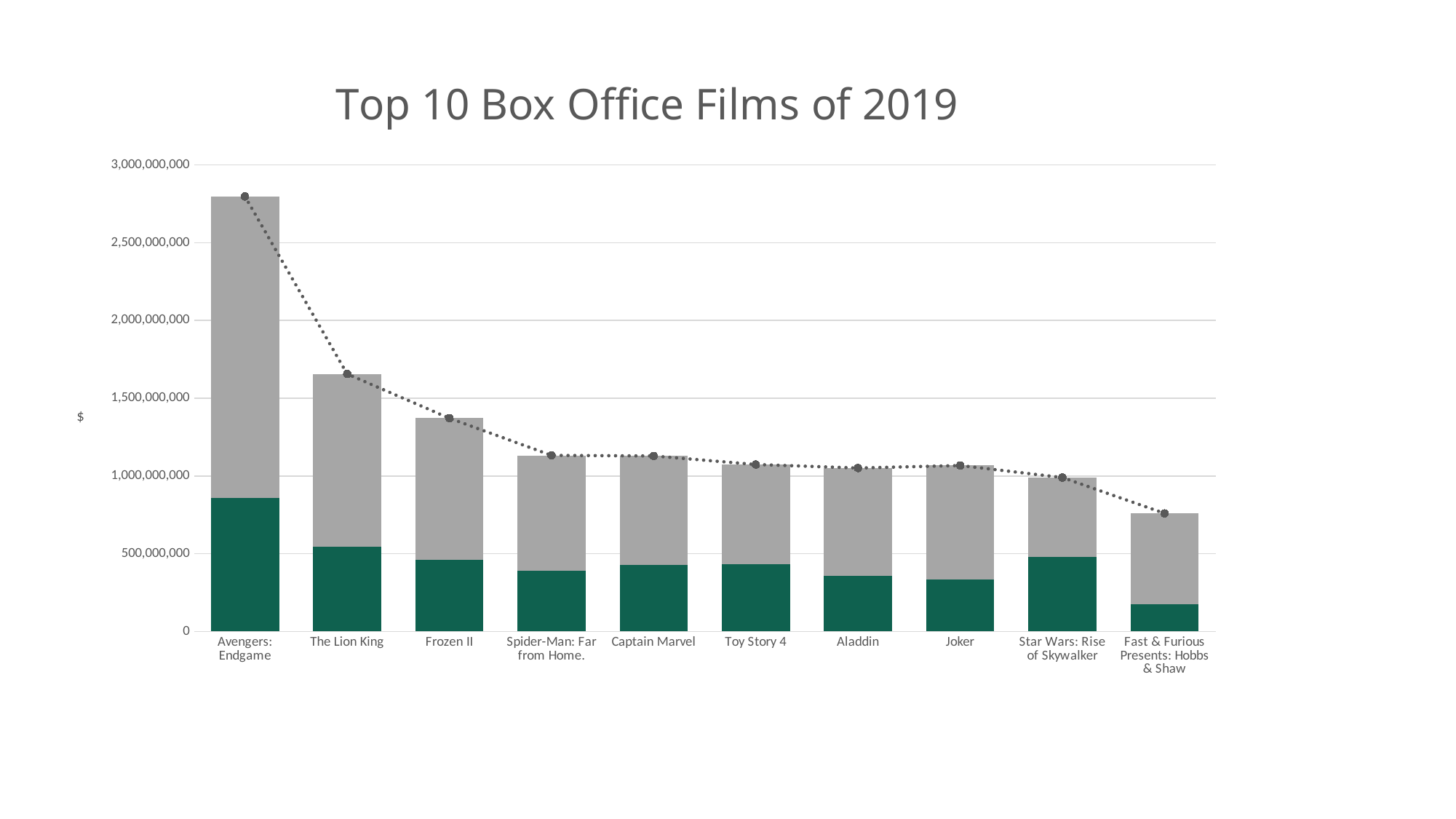
Is the total bar for The Lion King greater or less than 1,500,000,000? greater What is the title of the chart? Top 10 Box Office Films of 2019 What kind of chart is shown on the slide? Stacked bar chart with a line overlay Do the total bar values generally rise or fall from left to right along the x axis? fall How many films are shown on the x axis of the chart? 10 Is the total bar for Fast & Furious Presents: Hobbs & Shaw greater or less than 1,000,000,000? less Is the total bar for Frozen II greater or less than 1,500,000,000? less Which has the larger dark green segment, Star Wars: Rise of Skywalker or Joker? Star Wars: Rise of Skywalker Which film has the highest total bar in the chart? Avengers: Endgame Which film has the lowest total bar in the chart? Fast & Furious Presents: Hobbs & Shaw